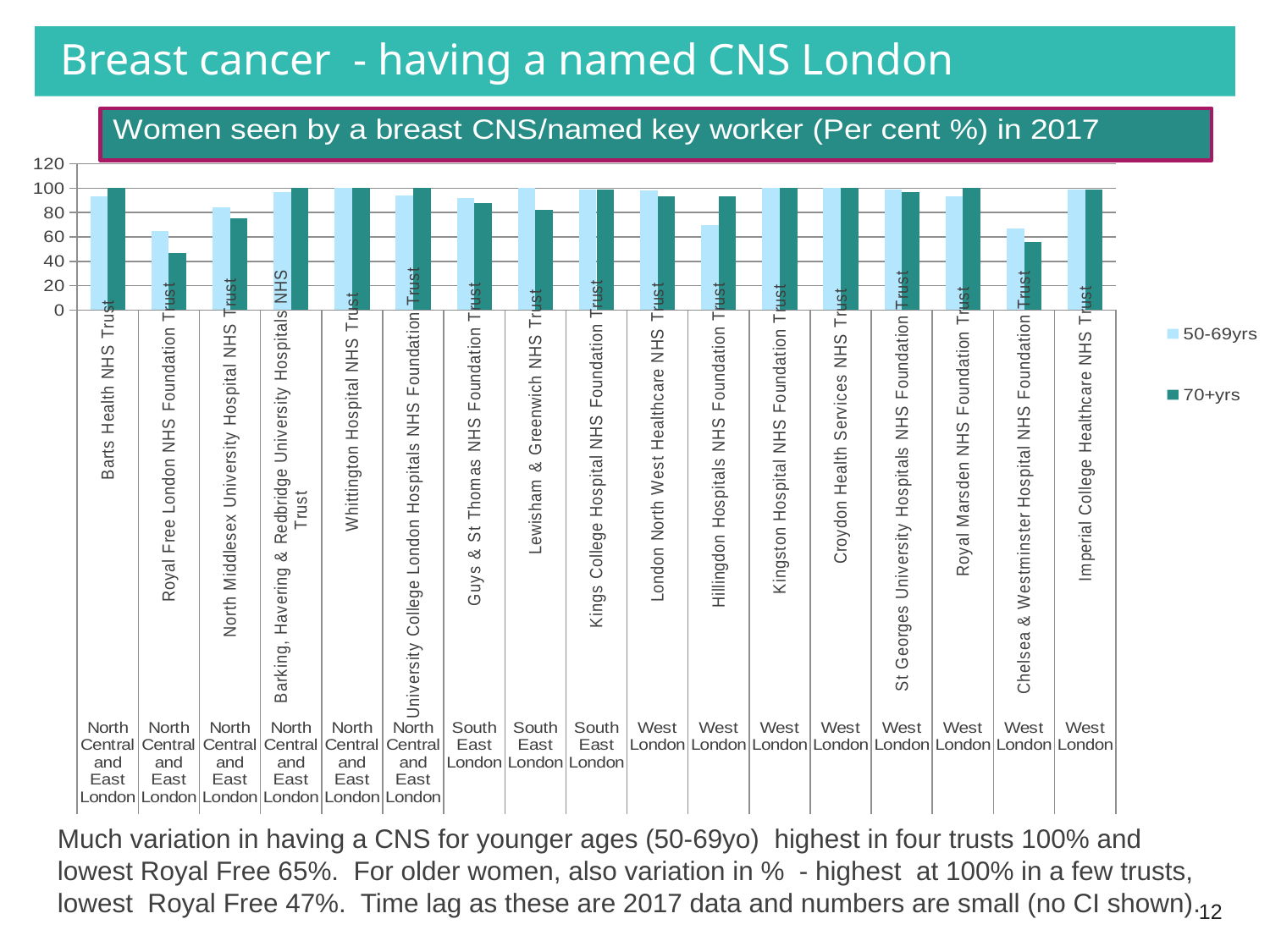
Is the value for the 50-69yrs series at Hillingdon Hospitals NHS Foundation Trust greater or less than 80? less At Chelsea & Westminster Hospital NHS Foundation Trust, which series has the larger value, 50-69yrs or 70+yrs? 50-69yrs What is the value for the 70+yrs series at Barts Health NHS Trust? 100 How many series does the legend list? 2 What is the title of the chart? Women seen by a breast CNS/named key worker (Per cent %) in 2017 Is the value for the 70+yrs series at Royal Free London NHS Foundation Trust greater or less than 60? less What is the value for the 50-69yrs series at Whittington Hospital NHS Trust? 100 Which trust has the lowest value for the 70+yrs series? Royal Free London NHS Foundation Trust At Royal Free London NHS Foundation Trust, which series has the larger value, 50-69yrs or 70+yrs? 50-69yrs How many trusts are shown on the x axis of the chart? 17 What kind of chart is shown on the slide? Bar chart Which trust has the lowest value for the 50-69yrs series? Royal Free London NHS Foundation Trust